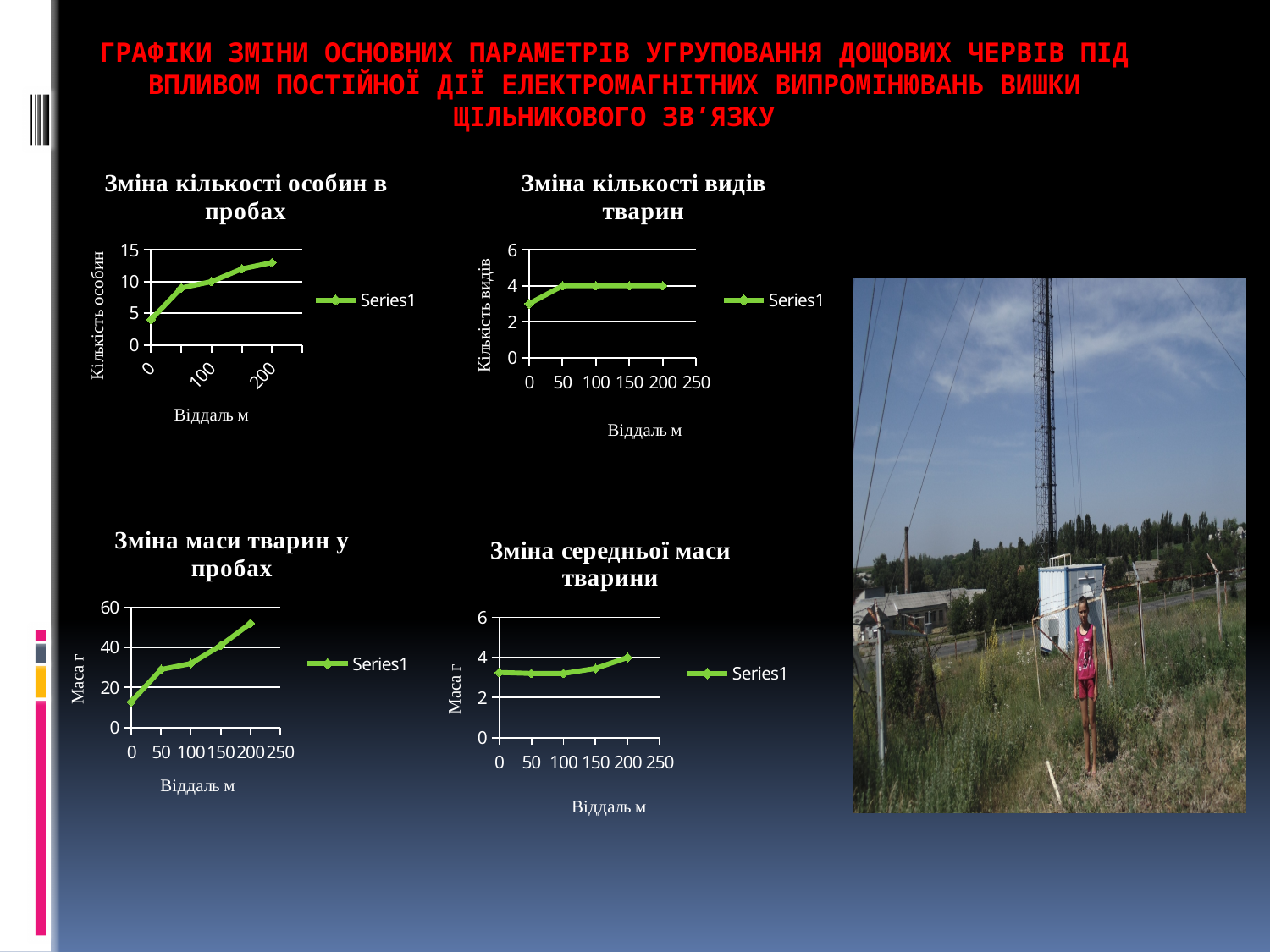
In the chart "Зміна кількості особин в пробах", is the value at distance 0 greater or less than 5? less In the chart "Зміна маси тварин у пробах", is the value at distance 200 greater or less than 40? greater In the chart "Зміна середньої маси тварини", is the value at distance 0 greater or less than 2? greater What is the x-axis label of the chart "Зміна маси тварин у пробах"? Віддаль м In the chart "Зміна кількості особин в пробах", do the values rise or fall as distance increases along the x axis? rise How many data points are plotted in the chart "Зміна маси тварин у пробах"? 5 In the chart "Зміна маси тварин у пробах", which distance has the lowest value? 0 What kind of chart is "Зміна кількості особин в пробах"? line chart In the chart "Зміна середньої маси тварини", which distance has the highest value? 200 How many series does the legend of the chart "Зміна кількості видів тварин" list? 1